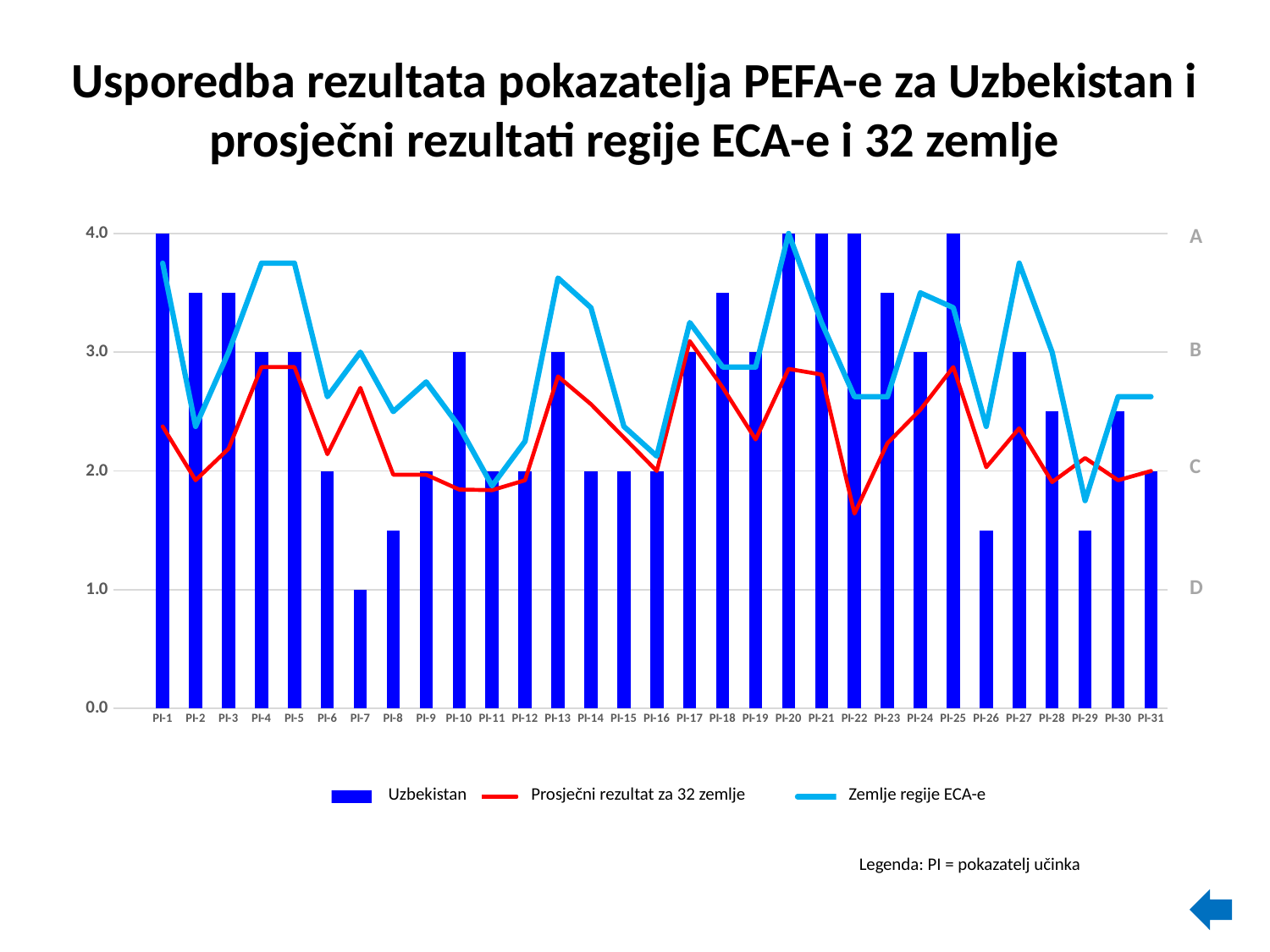
What is the Uzbekistan value for PI-4? 3.0 Which has the larger Uzbekistan value, PI-1 or PI-7? PI-1 What is the Uzbekistan value for PI-7? 1.0 How many series does the legend list? 3 Is the Uzbekistan value for PI-2 greater or less than 3.0? greater Which indicator has the lowest Uzbekistan bar? PI-7 What is the Uzbekistan value for PI-6? 2.0 How many performance indicators (PI) are shown on the x axis? 31 What is the difference between the Uzbekistan values for PI-1 and PI-7? 3.0 Is the Uzbekistan value for PI-8 greater or less than 2.0? less What is the Uzbekistan value for PI-1? 4.0 What kind of chart is shown on the slide? Combined bar and line chart